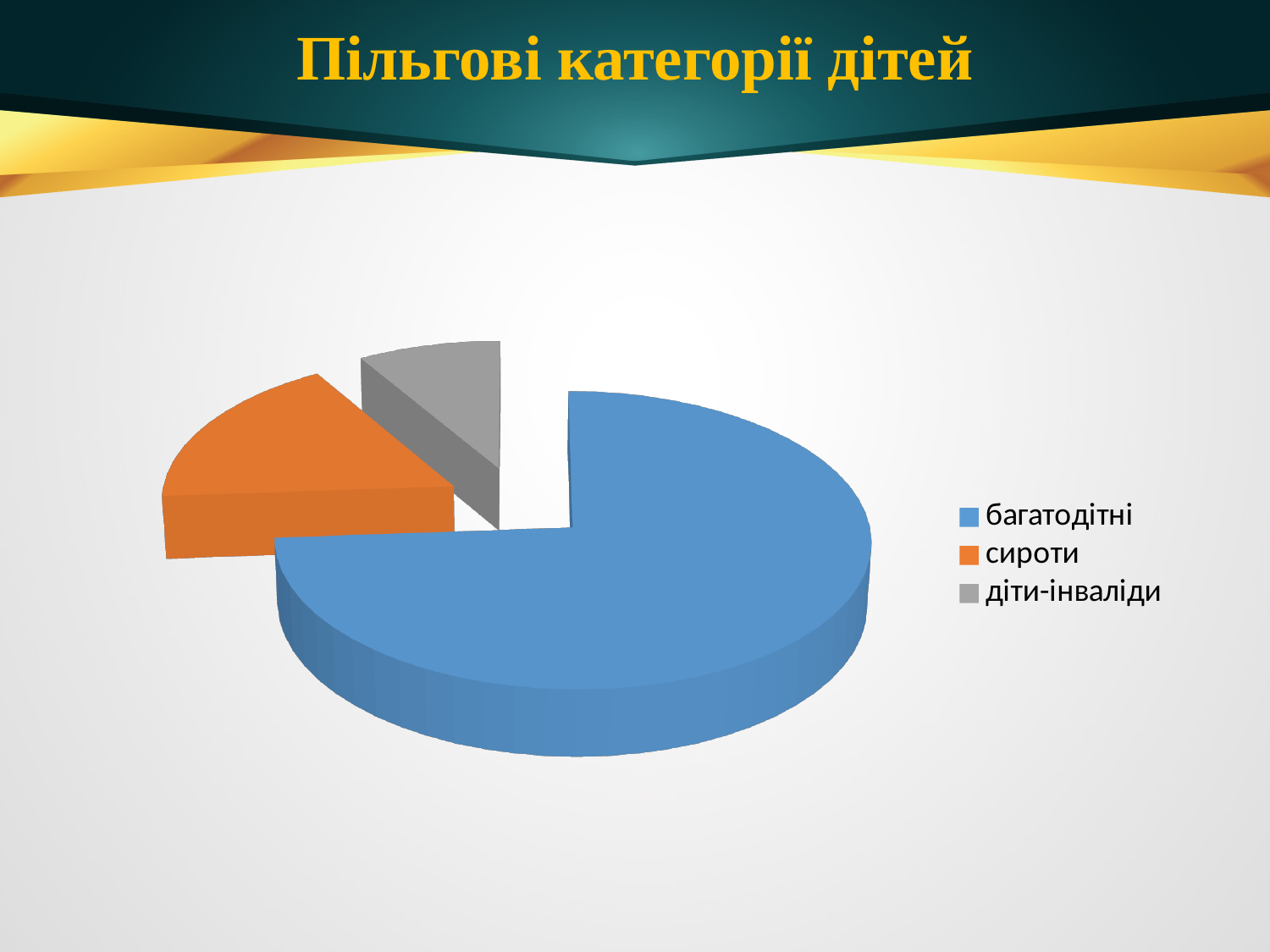
Which slice is larger, багатодітні or сироти? багатодітні What kind of chart is shown on the slide? pie chart How many categories does the pie chart show? 3 What is the title of the slide? Пільгові категорії дітей How many entries does the legend list? 3 Which category has the largest slice of the pie? багатодітні Which slice is larger, сироти or діти-інваліди? сироти Which category has the smallest slice of the pie? діти-інваліди What colour is the slice for сироти? orange